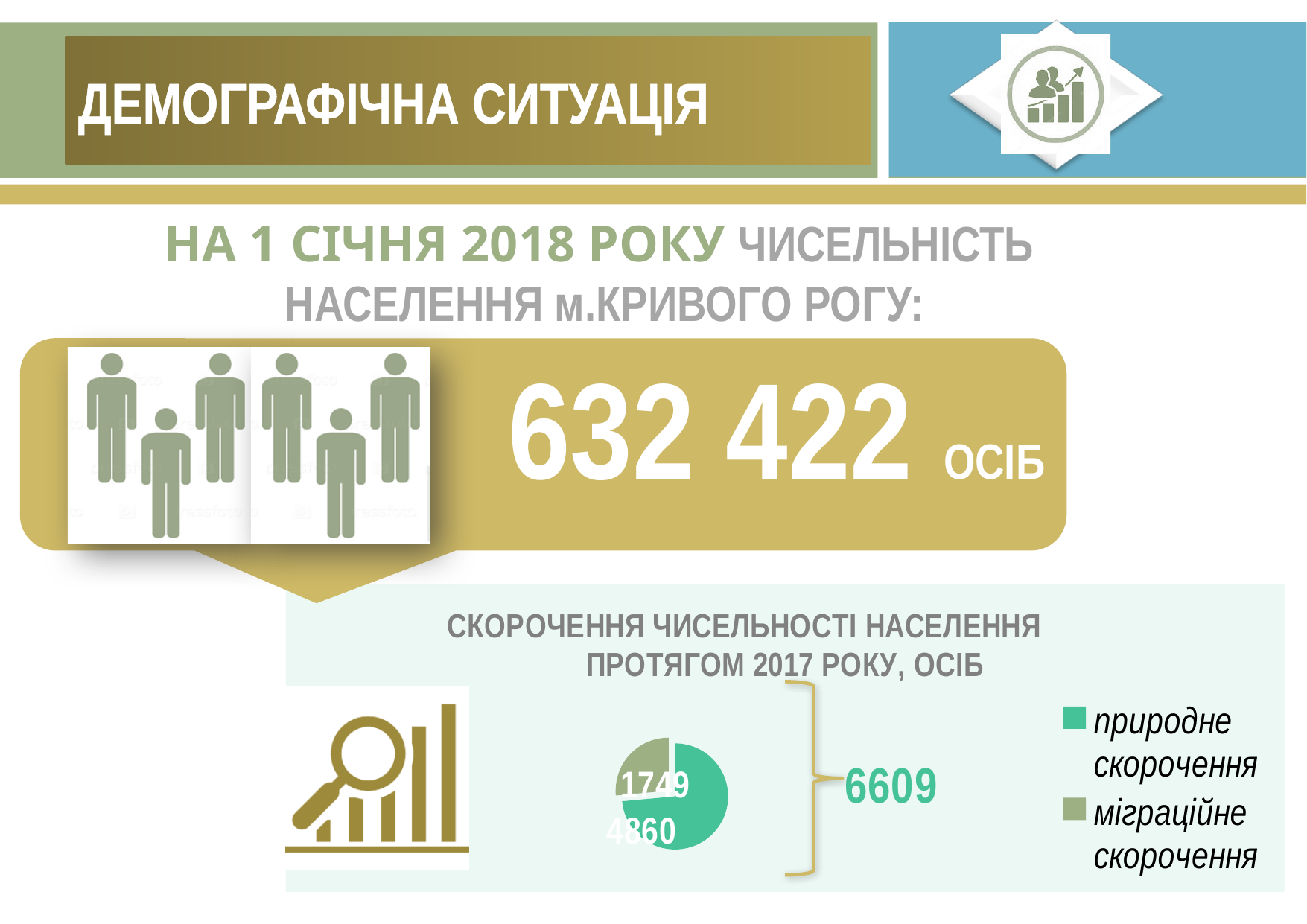
Which colour represents природне скорочення in the pie chart legend? teal (green) What is the value for природне скорочення in the pie chart? 4860 What is the title of the pie chart? СКОРОЧЕННЯ ЧИСЕЛЬНОСТІ НАСЕЛЕННЯ ПРОТЯГОМ 2017 РОКУ, ОСІБ What is the value for міграційне скорочення in the pie chart? 1749 What is the total of the two slices in the pie chart? 6609 Which is larger in the pie chart, природне скорочення or міграційне скорочення? природне скорочення What is the difference between природне скорочення and міграційне скорочення in the pie chart? 3111 How many slices does the pie chart have? 2 What kind of chart is shown on the slide? pie chart Which category has the largest slice in the pie chart? природне скорочення How many entries does the legend of the pie chart list? 2 Which category has the smallest slice in the pie chart? міграційне скорочення